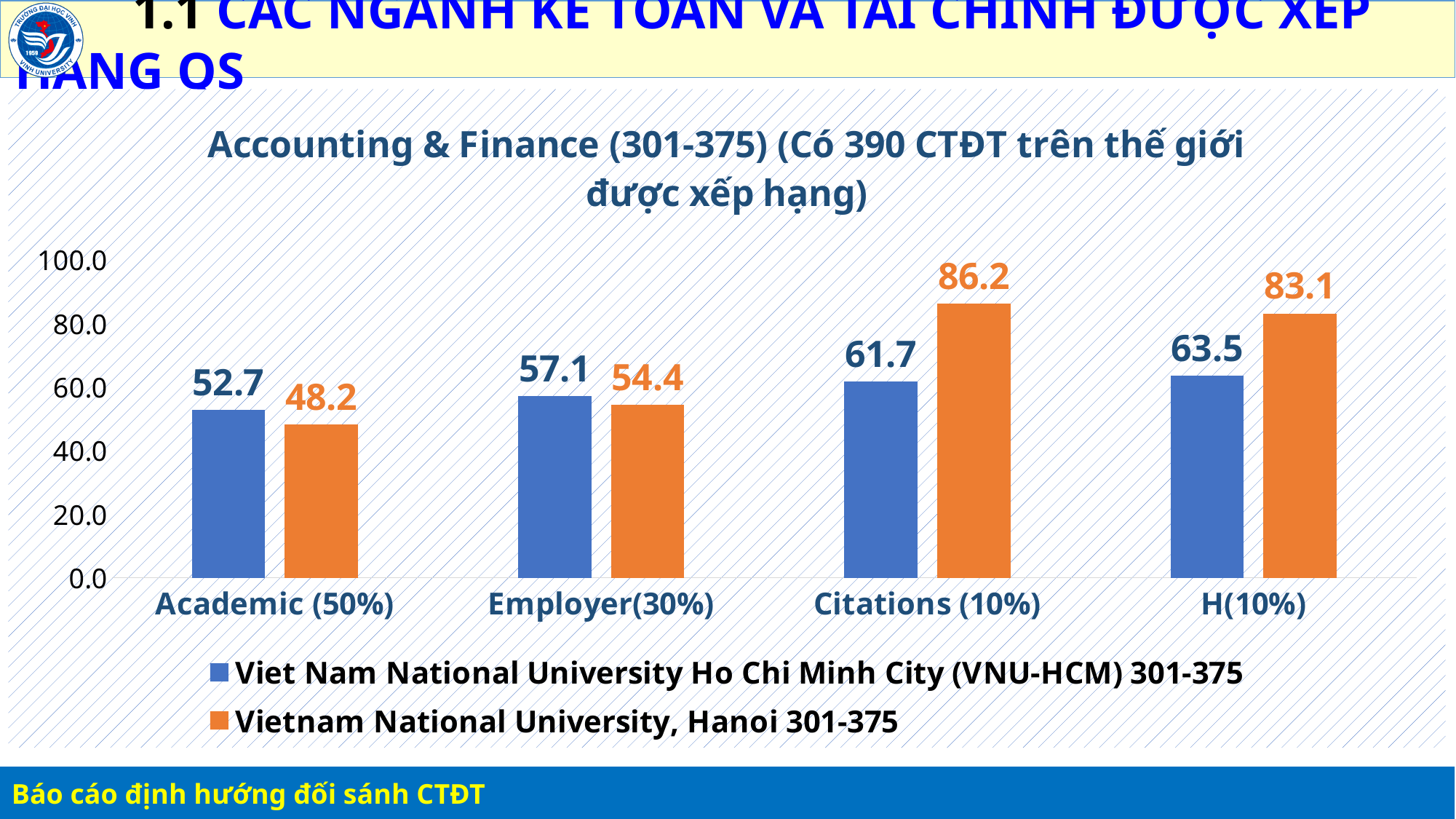
What is the value for Viet Nam National University Ho Chi Minh City (VNU-HCM) 301-375 in the Academic (50%) category? 52.7 Which colour represents Vietnam National University, Hanoi 301-375 in the chart? Orange What is the difference between the two universities' values in the Citations (10%) category? 24.5 Which university has the larger value in the Employer(30%) category? Viet Nam National University Ho Chi Minh City (VNU-HCM) 301-375 What is the value for Vietnam National University, Hanoi 301-375 in the H(10%) category? 83.1 How many series does the legend list? 2 What is the value for Vietnam National University, Hanoi 301-375 in the Citations (10%) category? 86.2 In which category does Viet Nam National University Ho Chi Minh City (VNU-HCM) 301-375 have its lowest value? Academic (50%) How many categories are shown on the x axis? 4 In which category does Vietnam National University, Hanoi 301-375 have its highest value? Citations (10%) What kind of chart is shown on the slide? Bar chart What is the value for Viet Nam National University Ho Chi Minh City (VNU-HCM) 301-375 in the Employer(30%) category? 57.1